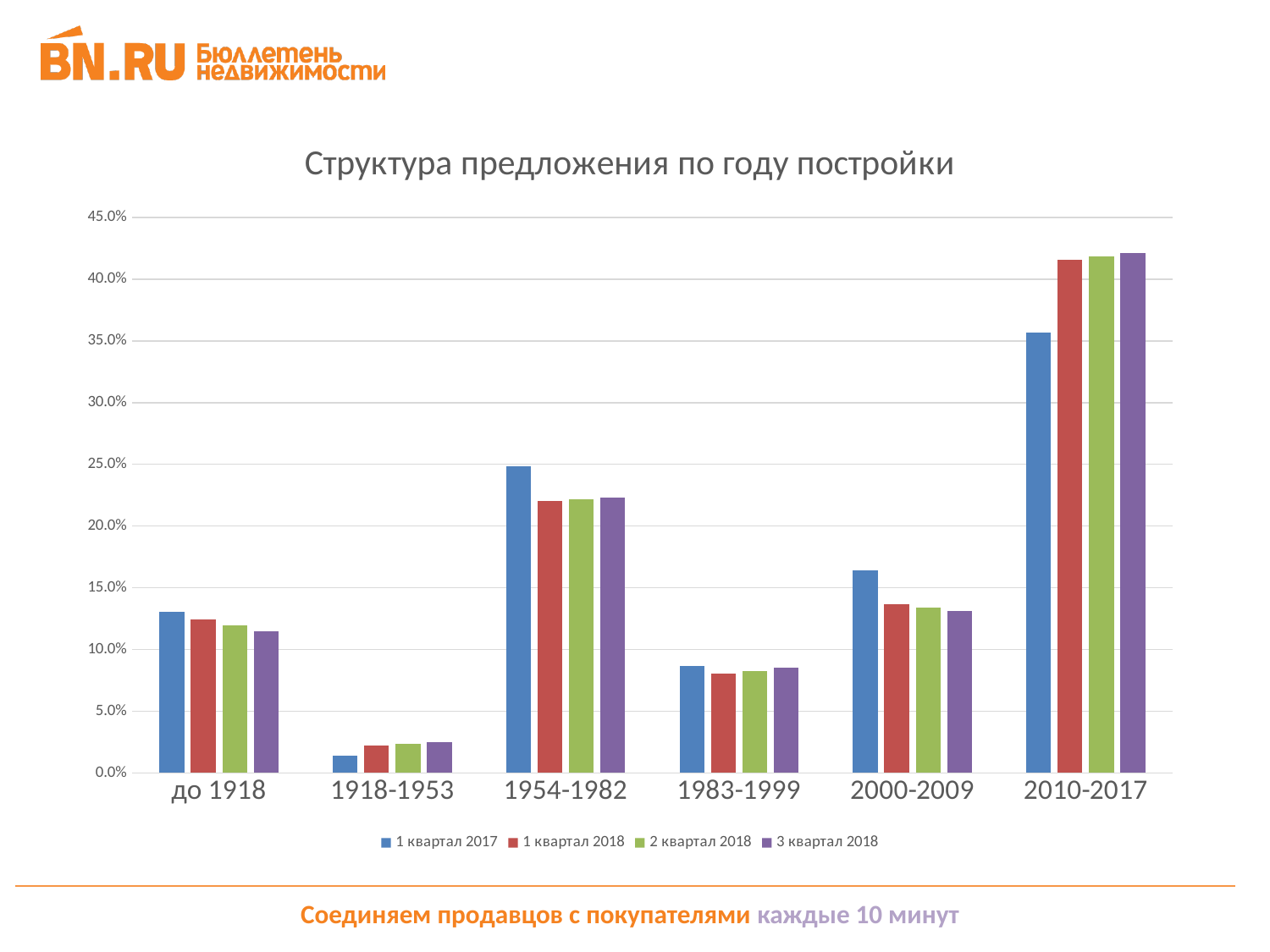
What is the title of the chart? Структура предложения по году постройки How many construction-year categories are shown on the x axis? 6 Is the value for 3 квартал 2018 in the 2010-2017 category greater or less than 40.0%? greater Is the value for 1 квартал 2018 in the 1918-1953 category greater or less than 5.0%? less Which category has the highest value for the series 1 квартал 2017? 2010-2017 How many series does the legend list? 4 In the 2010-2017 category, which series has the larger value: 1 квартал 2017 or 1 квартал 2018? 1 квартал 2018 What kind of chart is shown on the slide? bar chart Is the value for 1 квартал 2017 in the 2010-2017 category greater or less than 40.0%? less In the 2000-2009 category, which series has the larger value: 1 квартал 2017 or 3 квартал 2018? 1 квартал 2017 Which category has the lowest value for the series 3 квартал 2018? 1918-1953